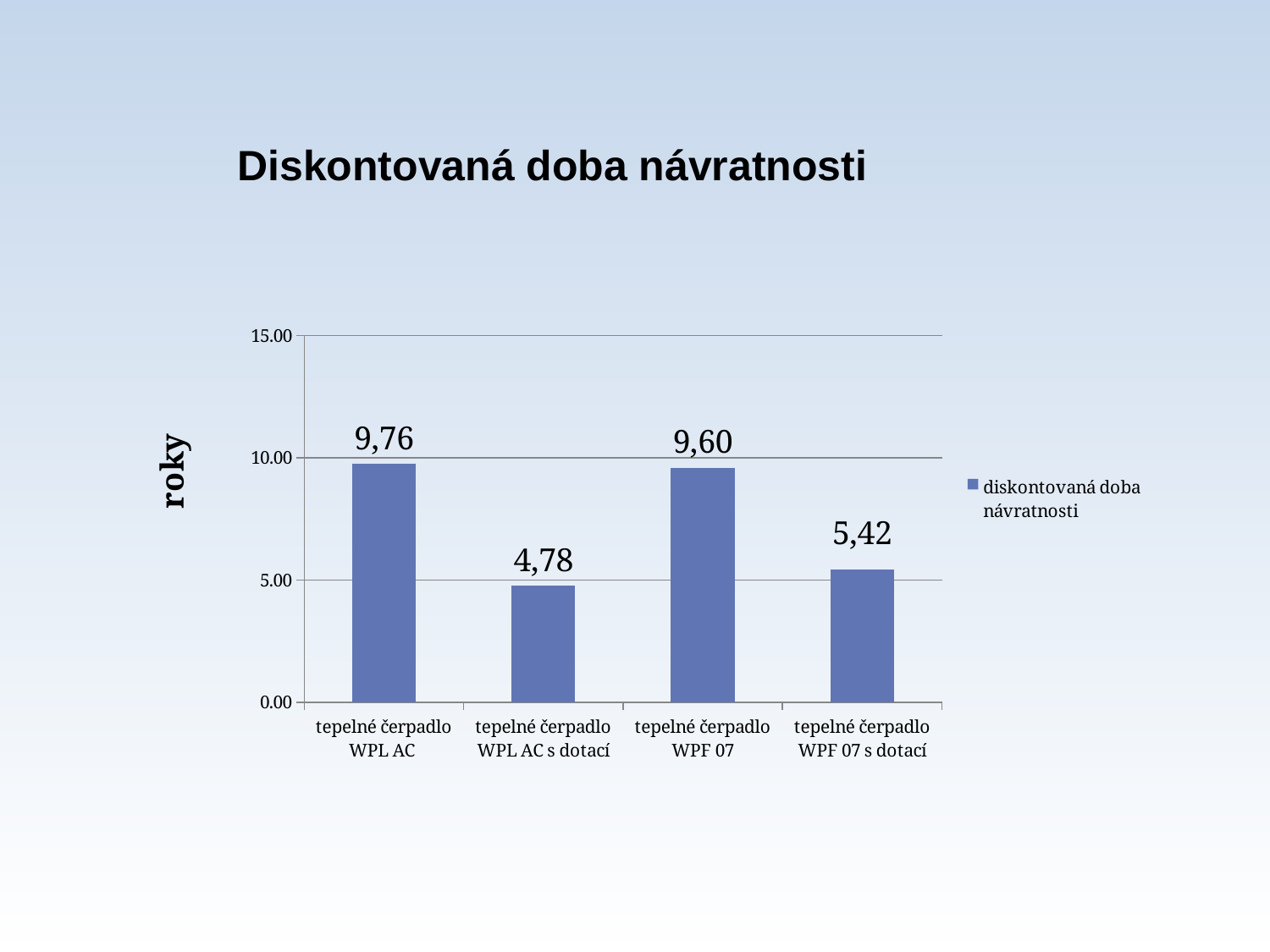
What is the value for tepelné čerpadlo WPF 07? 9,60 Which is larger, the value for tepelné čerpadlo WPL AC s dotací or tepelné čerpadlo WPF 07 s dotací? tepelné čerpadlo WPF 07 s dotací What kind of chart is shown on the slide? bar chart What is the value for tepelné čerpadlo WPF 07 s dotací? 5,42 What is the label of the y axis? roky What is the value for tepelné čerpadlo WPL AC? 9,76 How many categories are shown on the x axis? 4 What is the difference between the values for tepelné čerpadlo WPF 07 and tepelné čerpadlo WPF 07 s dotací? 4,18 What is the difference between the values for tepelné čerpadlo WPL AC and tepelné čerpadlo WPL AC s dotací? 4,98 Which category has the highest value? tepelné čerpadlo WPL AC What is the value for tepelné čerpadlo WPL AC s dotací? 4,78 Which category has the lowest value? tepelné čerpadlo WPL AC s dotací